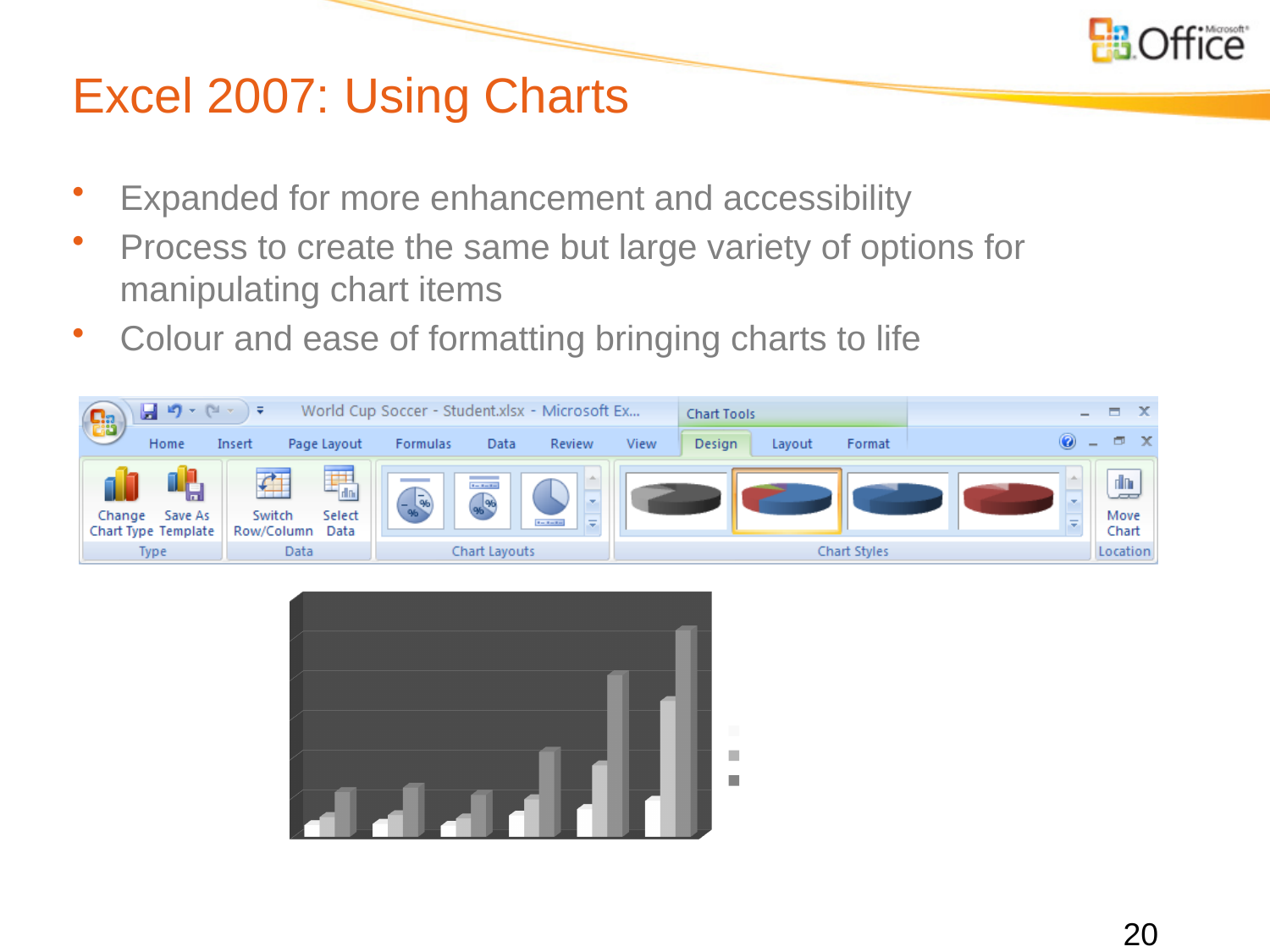
In the chart at the bottom of the slide, is the tallest bar in the rightmost group or the leftmost group? rightmost group In the chart at the bottom of the slide, which series has the tallest bar in every group: the first, second or third bar of each group? third How many bars are in each category group of the chart at the bottom of the slide? 3 Does the chart at the bottom of the slide display any data labels or axis values? No What kind of chart is shown at the bottom of the slide? bar chart How many groups of bars (categories) does the chart at the bottom of the slide show? 6 Is the chart at the bottom of the slide drawn in 3-D or flat 2-D style? 3-D How many series does the legend of the chart at the bottom of the slide list? 3 In the chart at the bottom of the slide, do the tallest bars generally rise or fall from left to right? rise